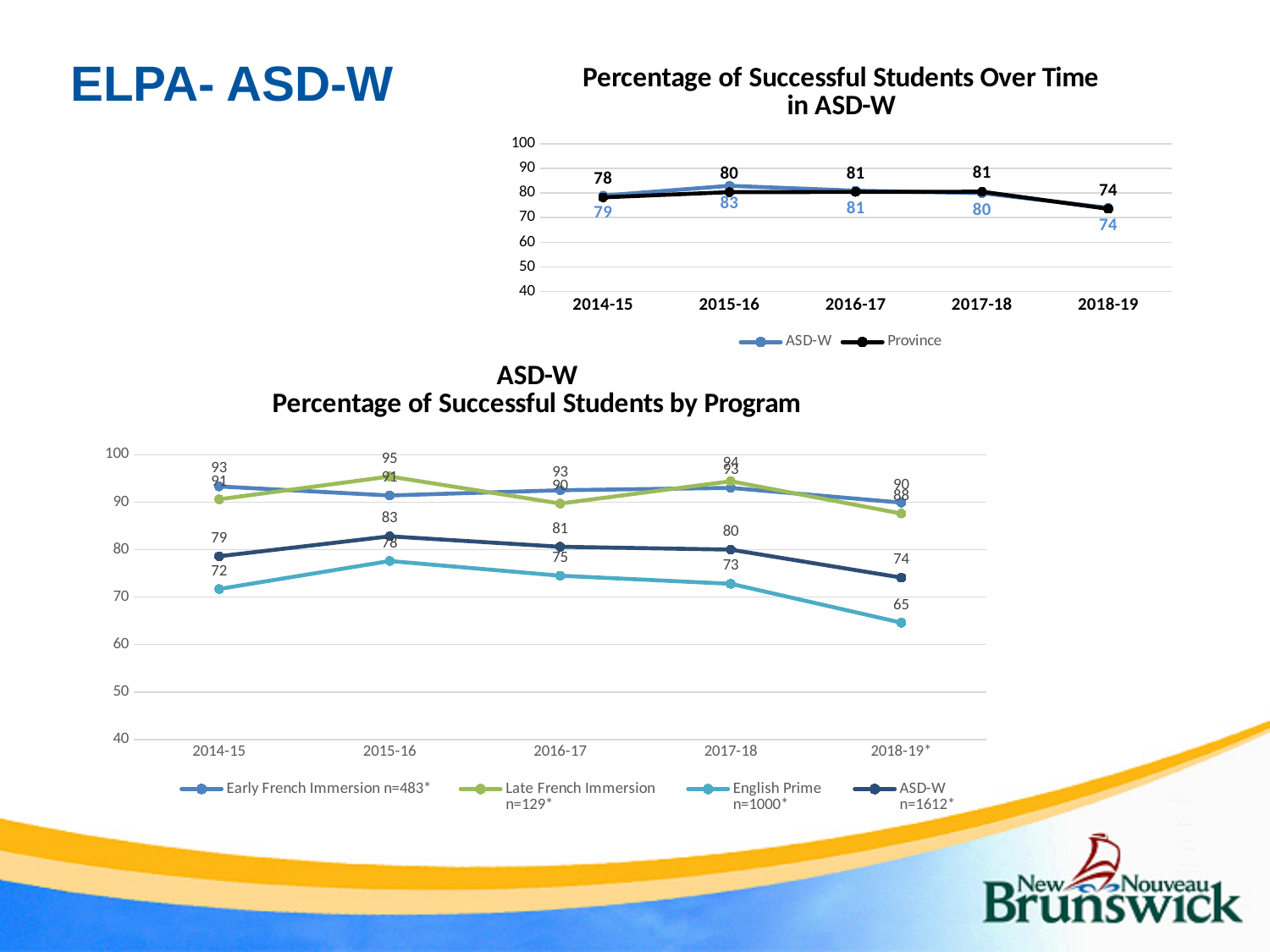
In the chart titled 'ASD-W Percentage of Successful Students by Program', what is the ASD-W value for 2015-16? 83 In the chart titled 'Percentage of Successful Students Over Time in ASD-W', what is the ASD-W value for 2015-16? 83 In the chart titled 'Percentage of Successful Students Over Time in ASD-W', in which year is the ASD-W value highest? 2015-16 In the chart titled 'Percentage of Successful Students Over Time in ASD-W', how many series does the legend list? 2 In the chart titled 'ASD-W Percentage of Successful Students by Program', how many years are shown on the x axis? 5 In the chart titled 'Percentage of Successful Students Over Time in ASD-W', what is the difference between the ASD-W and Province values in 2015-16? 3 In the chart titled 'ASD-W Percentage of Successful Students by Program', how many series does the legend list? 4 What kind of chart is the top chart, 'Percentage of Successful Students Over Time in ASD-W'? line chart In the chart titled 'ASD-W Percentage of Successful Students by Program', which is larger in 2015-16: Early French Immersion or Late French Immersion? Late French Immersion In the chart titled 'Percentage of Successful Students Over Time in ASD-W', what is the Province value for 2018-19? 74 In the chart titled 'ASD-W Percentage of Successful Students by Program', in which year is the English Prime value lowest? 2018-19* In the chart titled 'ASD-W Percentage of Successful Students by Program', what is the English Prime value for 2018-19*? 65